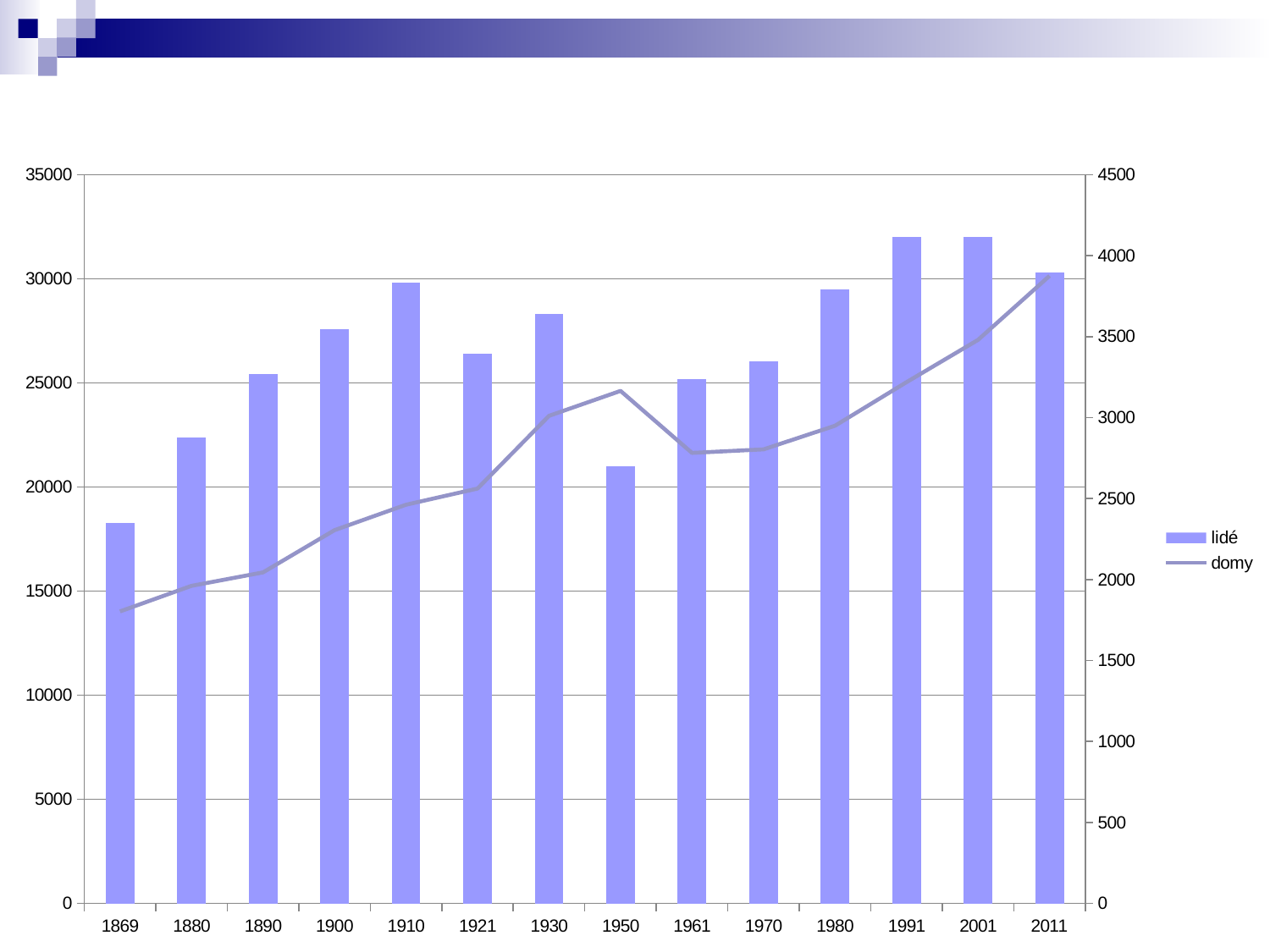
How many categories (years) are shown on the x axis of the chart? 14 Is the domy value for 1869 greater or less than 2000 on the right axis? less Is the lidé value for 1869 greater or less than 20000? less What are the names of the two series in the legend? lidé and domy What kind of chart is shown on the slide? bar chart combined with a line Which year has the larger lidé bar, 1930 or 1950? 1930 Which year has the lowest bar for lidé? 1869 Is the lidé value for 1930 greater or less than 25000? greater Do the lidé bars rise or fall from 1869 to 1910? rise How many series does the chart's legend list? 2